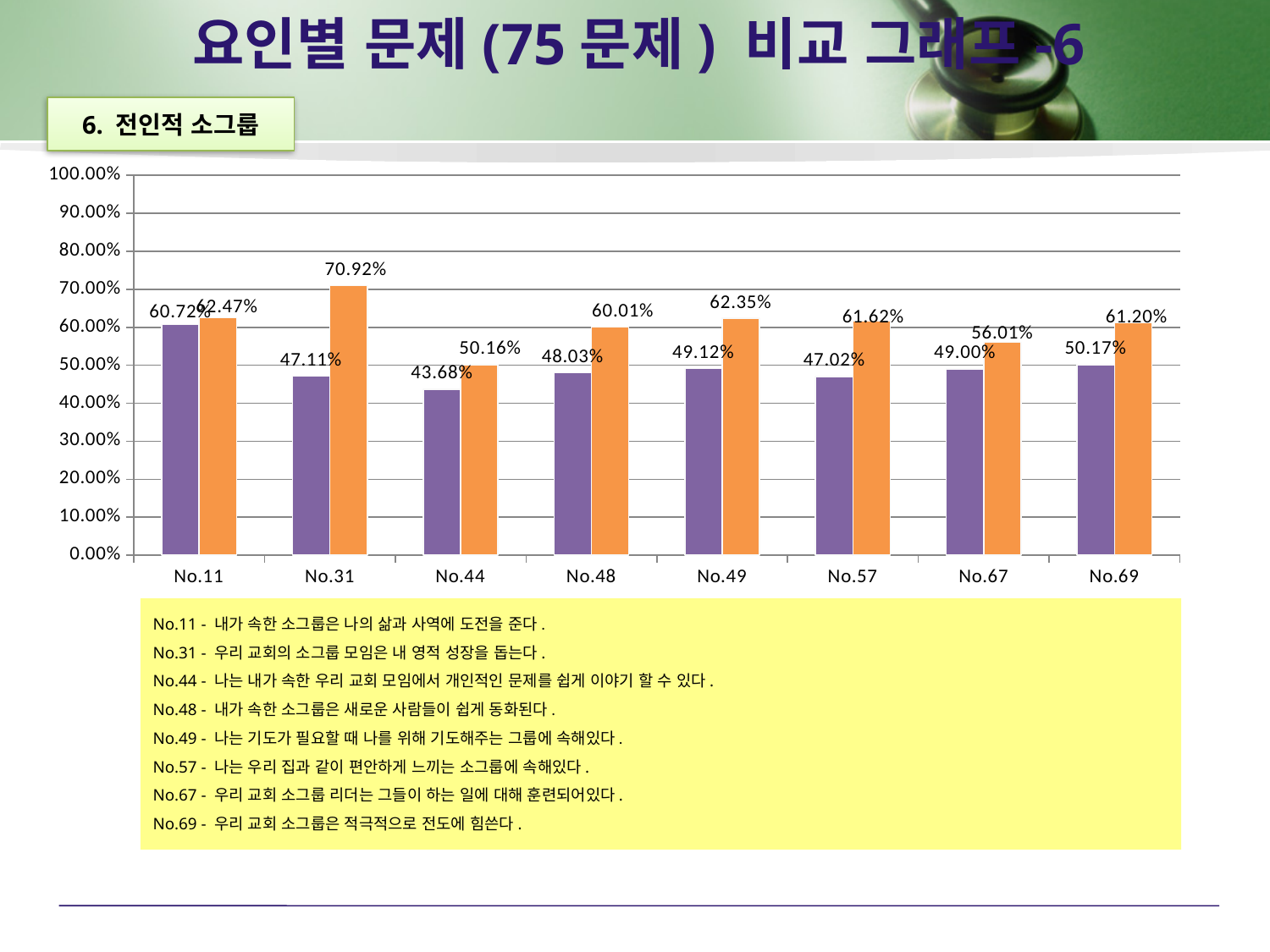
What is the subtitle shown in the green box above the chart? 6. 전인적 소그룹 Which category has the highest orange bar? No.31 Which category has the lowest purple bar? No.44 What is the difference between the orange and purple bars for No.31? 23.81% What is the value of the orange bar for No.67? 56.01% What kind of chart is shown on the slide? bar chart What is the value of the purple bar for No.11? 60.72% How many categories are shown on the x axis? 8 Which is larger for No.57, the purple bar or the orange bar? the orange bar What is the value of the orange bar for No.31? 70.92% What is the value of the purple bar for No.44? 43.68% Is the value of the orange bar for No.49 greater or less than 60.00%? greater